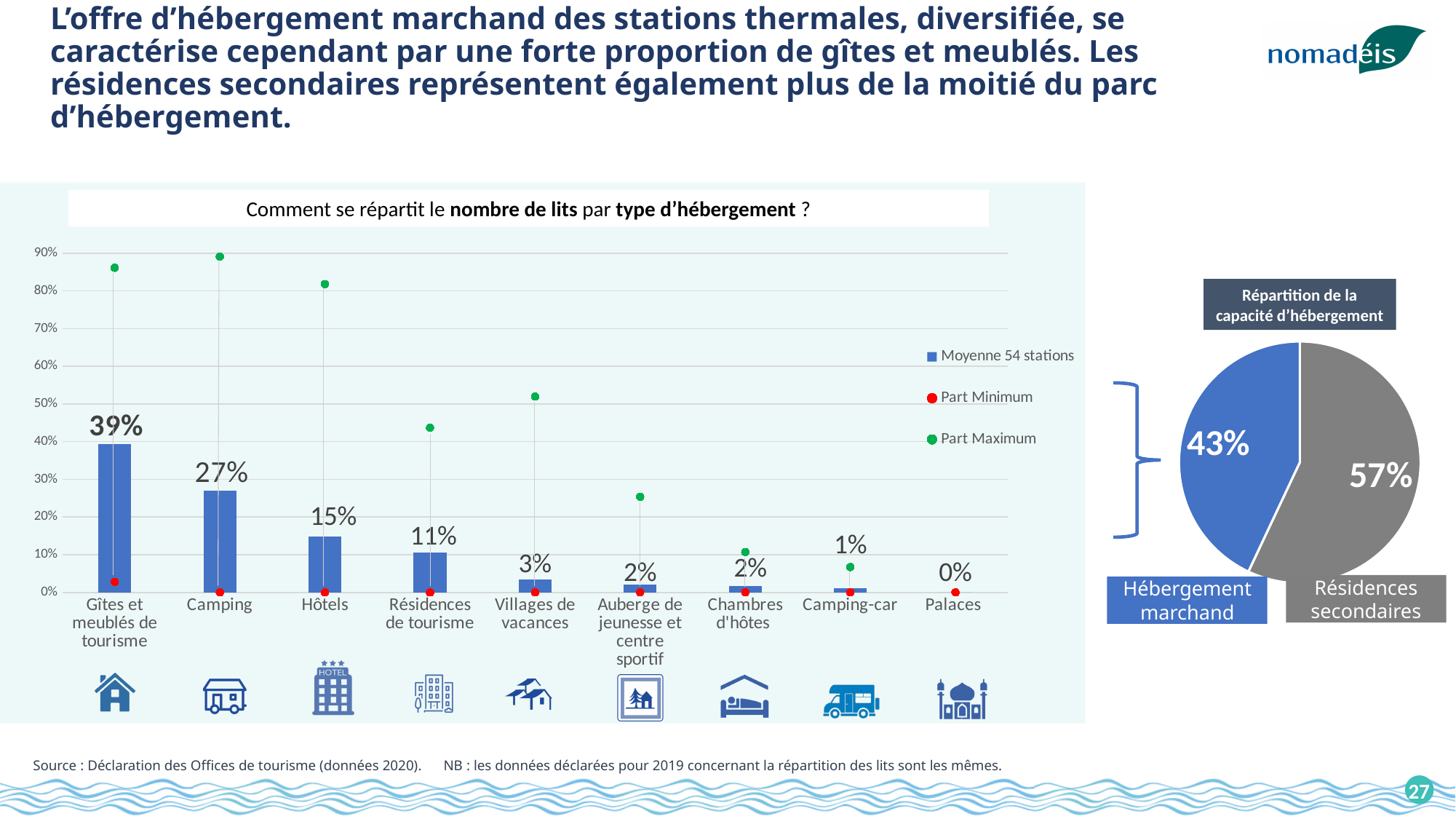
In the bar chart 'Comment se répartit le nombre de lits par type d'hébergement ?', which has a larger Moyenne 54 stations value: Résidences de tourisme or Villages de vacances? Résidences de tourisme In the bar chart 'Comment se répartit le nombre de lits par type d'hébergement ?', what is the difference between the Moyenne 54 stations values for Gîtes et meublés de tourisme and Camping? 12% How many accommodation types are shown on the x axis of the bar chart 'Comment se répartit le nombre de lits par type d'hébergement ?'? 9 In the bar chart 'Comment se répartit le nombre de lits par type d'hébergement ?', is the Part Maximum value for Camping greater or less than 80%? greater How many series does the legend of the bar chart 'Comment se répartit le nombre de lits par type d'hébergement ?' list? 3 What kind of chart is 'Répartition de la capacité d'hébergement'? Pie chart In the pie chart 'Répartition de la capacité d'hébergement', what share is Résidences secondaires? 57% In the bar chart 'Comment se répartit le nombre de lits par type d'hébergement ?', what is the Moyenne 54 stations value for Hôtels? 15% In the bar chart 'Comment se répartit le nombre de lits par type d'hébergement ?', what is the Moyenne 54 stations value for Camping? 27% In the bar chart 'Comment se répartit le nombre de lits par type d'hébergement ?', is the Part Maximum value for Auberge de jeunesse et centre sportif greater or less than 20%? greater In the bar chart 'Comment se répartit le nombre de lits par type d'hébergement ?', which accommodation type has the lowest Moyenne 54 stations value? Palaces In the bar chart 'Comment se répartit le nombre de lits par type d'hébergement ?', which accommodation type has the highest Moyenne 54 stations value? Gîtes et meublés de tourisme